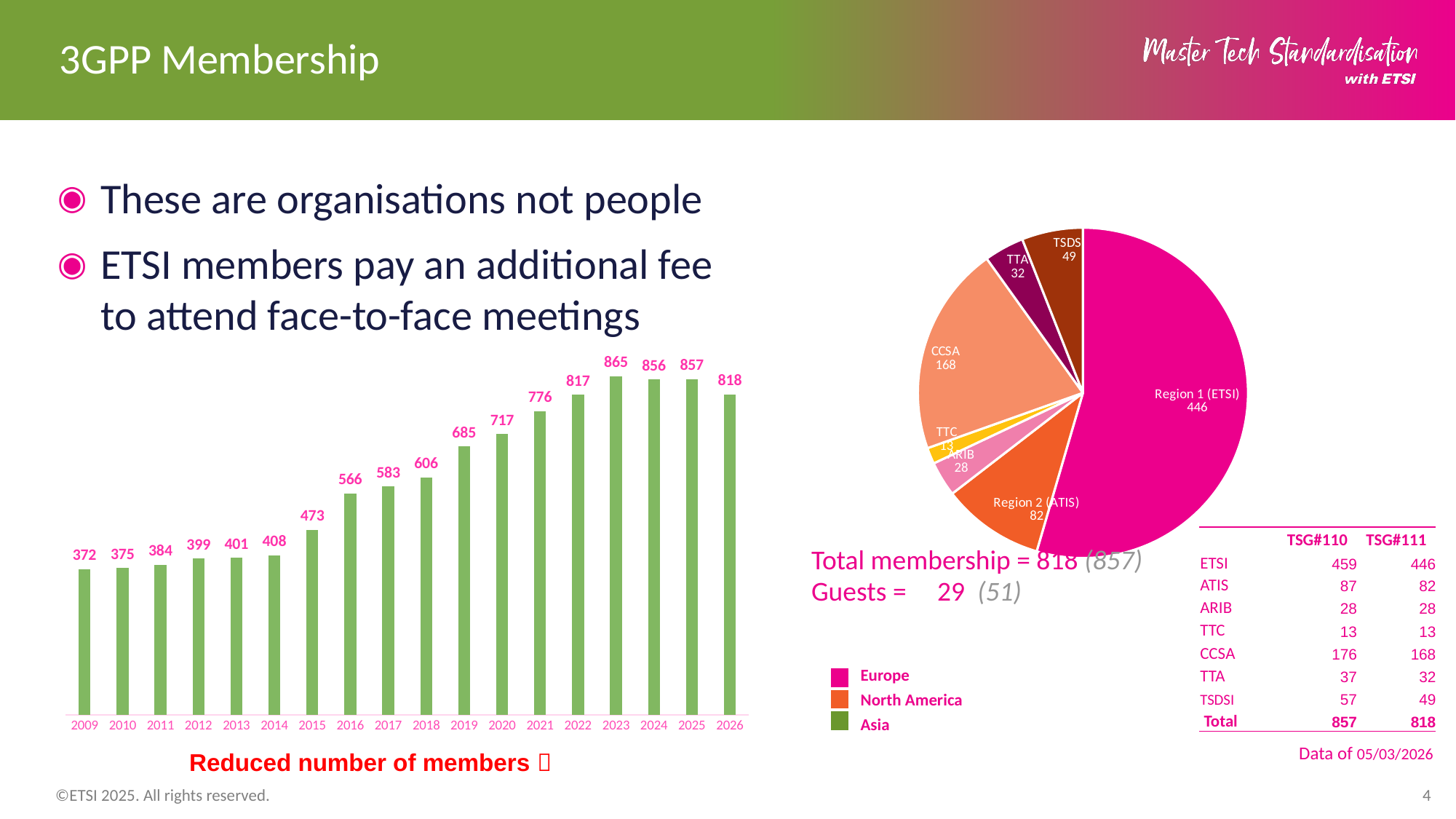
On the bar chart of 3GPP membership by year, what is the value for 2023? 865 On the bar chart of 3GPP membership by year, which year has the highest value? 2023 On the bar chart of 3GPP membership by year, what is the value for 2009? 372 On the bar chart of 3GPP membership by year, what is the difference between the values for 2025 and 2026? 39 On the bar chart of 3GPP membership by year, how many years are shown? 18 On the pie chart of membership by region, which slice is the largest? Region 1 (ETSI) How many entries does the legend of the pie chart list? 3 On the pie chart of membership by region, what is the value for CCSA? 168 On the bar chart of 3GPP membership by year, which is larger, the value for 2024 or the value for 2025? 2025 On the bar chart of 3GPP membership by year, which year has the lowest value? 2009 What kind of chart is the chart on the left showing membership by year? Bar chart On the bar chart of 3GPP membership by year, do the values generally rise or fall from 2009 to 2023? Rise